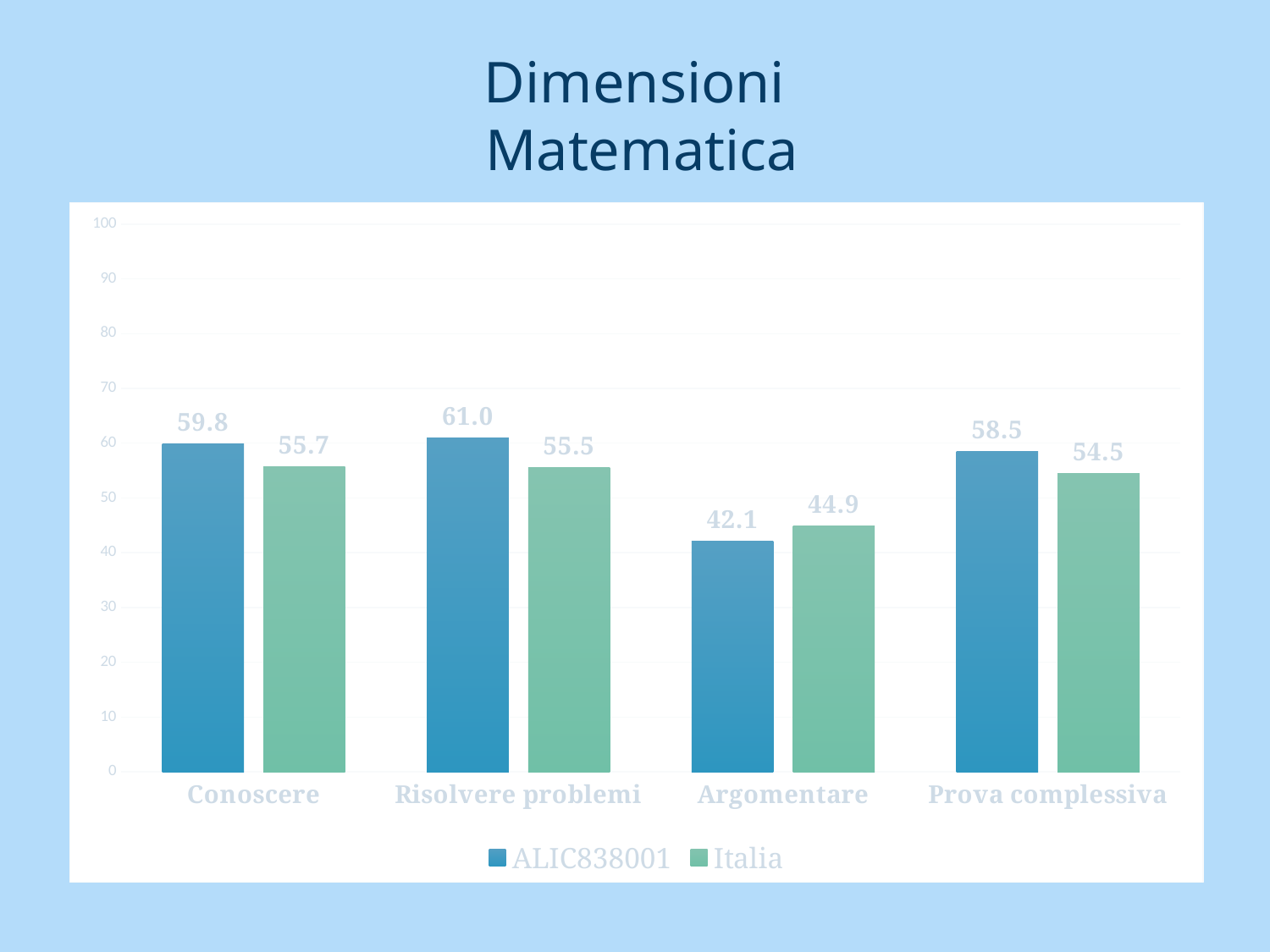
What is the title of the slide? Dimensioni Matematica What is the value for ALIC838001 in the Prova complessiva category? 58.5 What is the value for ALIC838001 in the Conoscere category? 59.8 In the Argomentare category, which series has the larger value, ALIC838001 or Italia? Italia How many series does the legend list? 2 Which category has the lowest value for Italia? Argomentare How many categories are shown on the x axis? 4 What is the value for Italia in the Argomentare category? 44.9 Which category has the highest value for ALIC838001? Risolvere problemi Is the value for Italia in the Conoscere category greater or less than 50? greater What kind of chart is shown on the slide? bar chart What is the difference between ALIC838001 and Italia in the Risolvere problemi category? 5.5